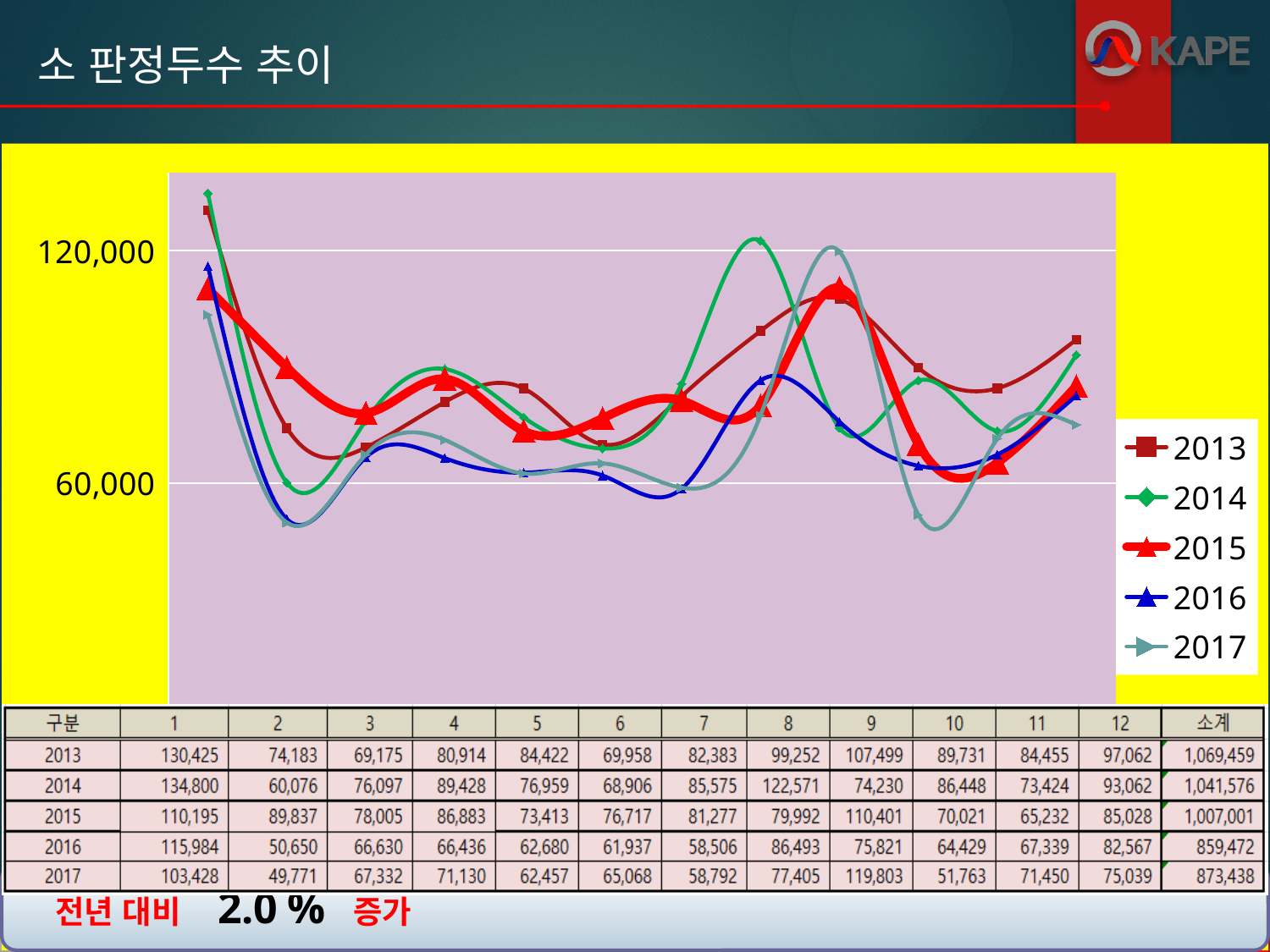
What is the difference between the month 1 values for 2014 and 2013? 4,375 Which is larger in month 2: the value for 2015 or the value for 2016? 2015 What kind of chart is shown on the slide? line chart In which month is the 2016 series lowest? 2 How many monthly data points does each series have? 12 In which month is the 2013 series highest? 1 Is the value for 2014 in month 8 greater or less than 120,000? greater What is the 소계 (total) for 2015? 1,007,001 What is the value for 2014 in month 8? 122,571 What are the legend entries of the chart? 2013, 2014, 2015, 2016, 2017 What is the value for 2017 in month 9? 119,803 How many series does the legend list? 5